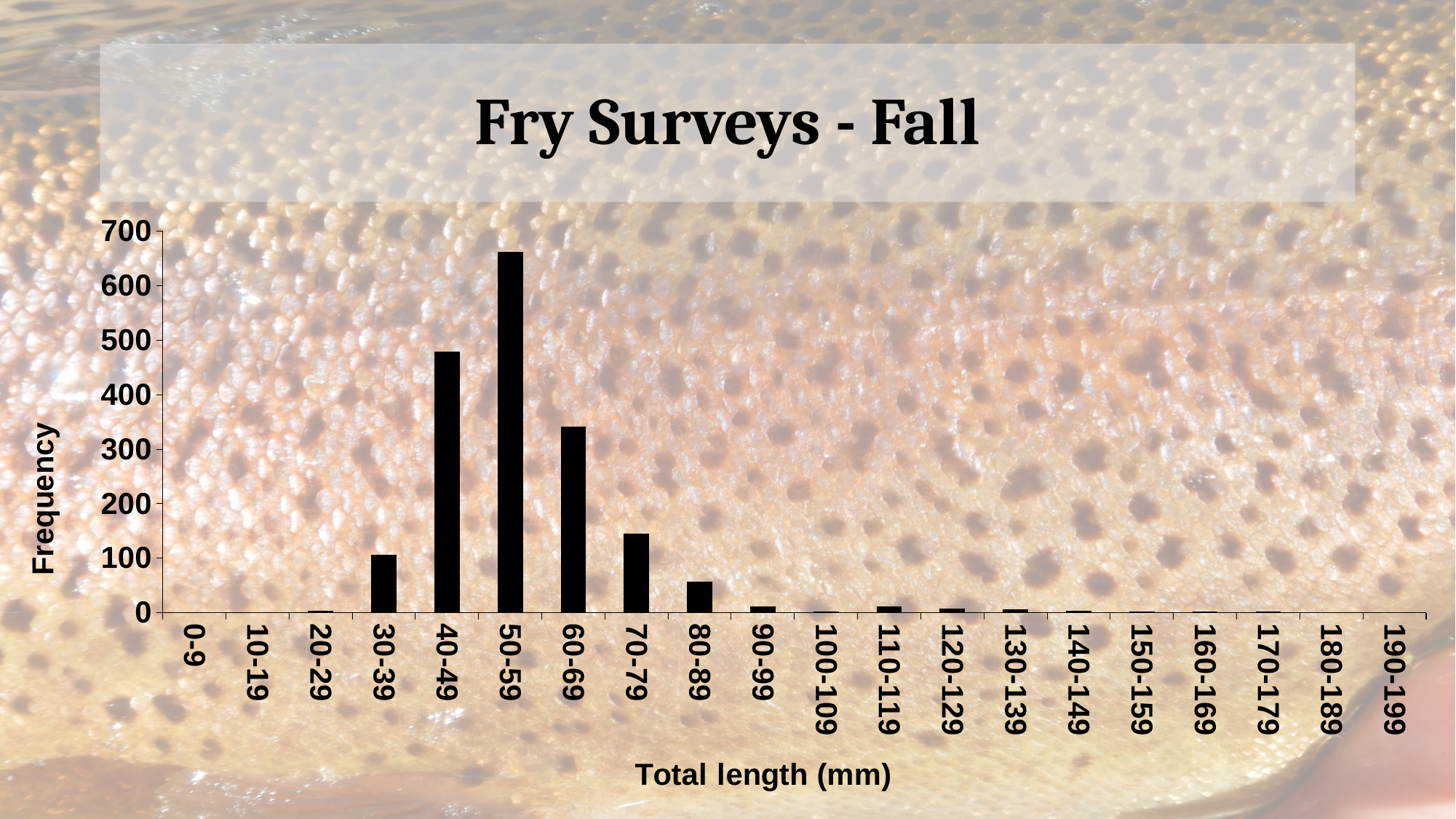
What is the label of the x axis? Total length (mm) Do the frequencies rise or fall from the 50-59 mm category to the 80-89 mm category? fall Is the frequency for the 60-69 mm category greater or less than 300? greater What is the title of the chart? Fry Surveys - Fall Which has a higher frequency, the 70-79 mm category or the 80-89 mm category? 70-79 How many total length categories are shown on the x axis? 20 What kind of chart is shown on the slide? bar chart Is the frequency for the 50-59 mm category greater or less than 600? greater Which total length category has the highest frequency? 50-59 Is the frequency for the 30-39 mm category greater or less than 200? less Which has a higher frequency, the 40-49 mm category or the 60-69 mm category? 40-49